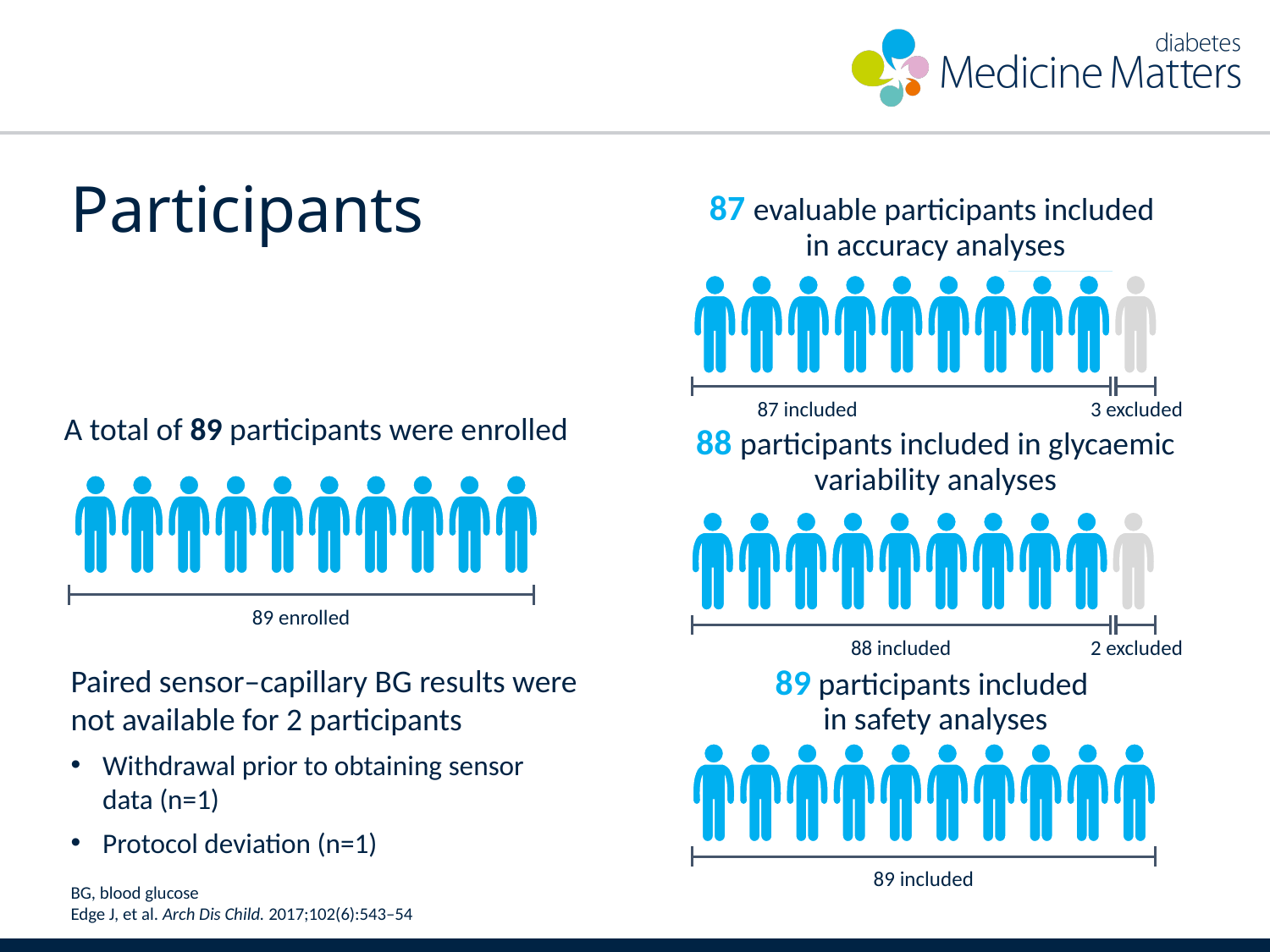
In the glycaemic variability analyses pictogram, how many participants were excluded? 2 excluded In the accuracy analyses pictogram, what colour are the excluded participant figures? Grey In the enrolment pictogram on the left, how many participants were enrolled? 89 enrolled Which analysis pictogram on the right shows the highest number of included participants? Safety analyses (89 included) What kind of chart is used to show the participant numbers on this slide? Pictogram (icon chart of people figures) In the glycaemic variability analyses pictogram, how many participants were included? 88 included What is the difference between the number enrolled (89) and the number included in the accuracy analyses (87)? 2 Which is larger: the number excluded from the accuracy analyses or the number excluded from the glycaemic variability analyses? Accuracy analyses (3 excluded) In the accuracy analyses pictogram on the right, how many participants were included? 87 included Which analysis pictogram on the right shows the lowest number of included participants? Accuracy analyses (87 included) In the accuracy analyses pictogram on the right, how many participants were excluded? 3 excluded In the safety analyses pictogram, how many participants were included? 89 included